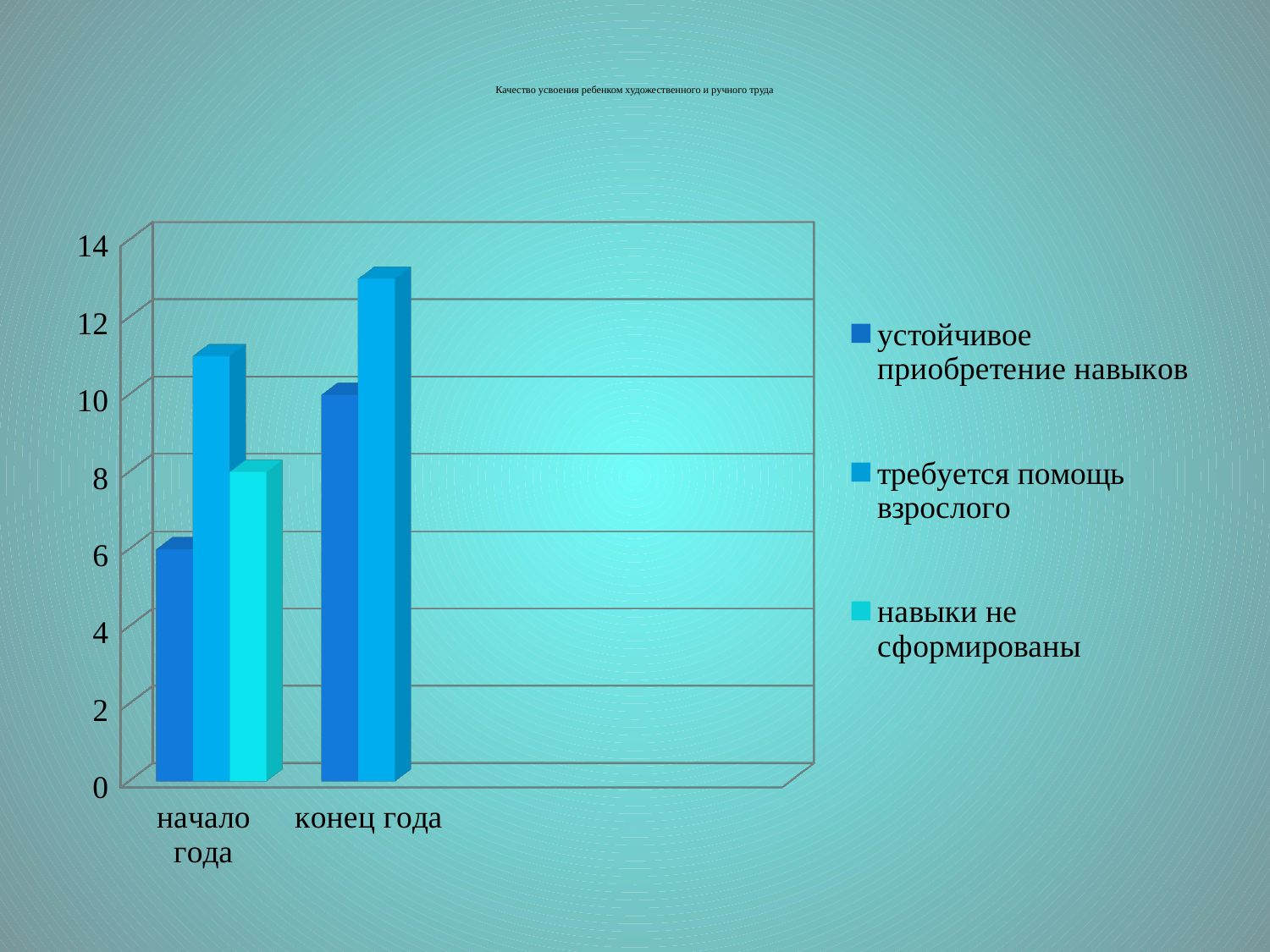
Does the value for 'устойчивое приобретение навыков' rise or fall from 'начало года' to 'конец года'? rise Is the value for 'требуется помощь взрослого' at 'конец года' greater or less than 12? greater Is the value for 'навыки не сформированы' at 'начало года' greater or less than 10? less What is the title of the chart on the slide? Качество усвоения ребенком художественного и ручного труда Is the value for 'устойчивое приобретение навыков' at 'начало года' greater or less than 8? less How many categories are shown on the x axis of the chart? 2 What kind of chart is shown on the slide? bar chart Which series has the highest value at 'конец года'? требуется помощь взрослого Which series has the lowest value at 'начало года'? устойчивое приобретение навыков How many series does the chart's legend list? 3 Which series is listed last in the chart's legend? навыки не сформированы